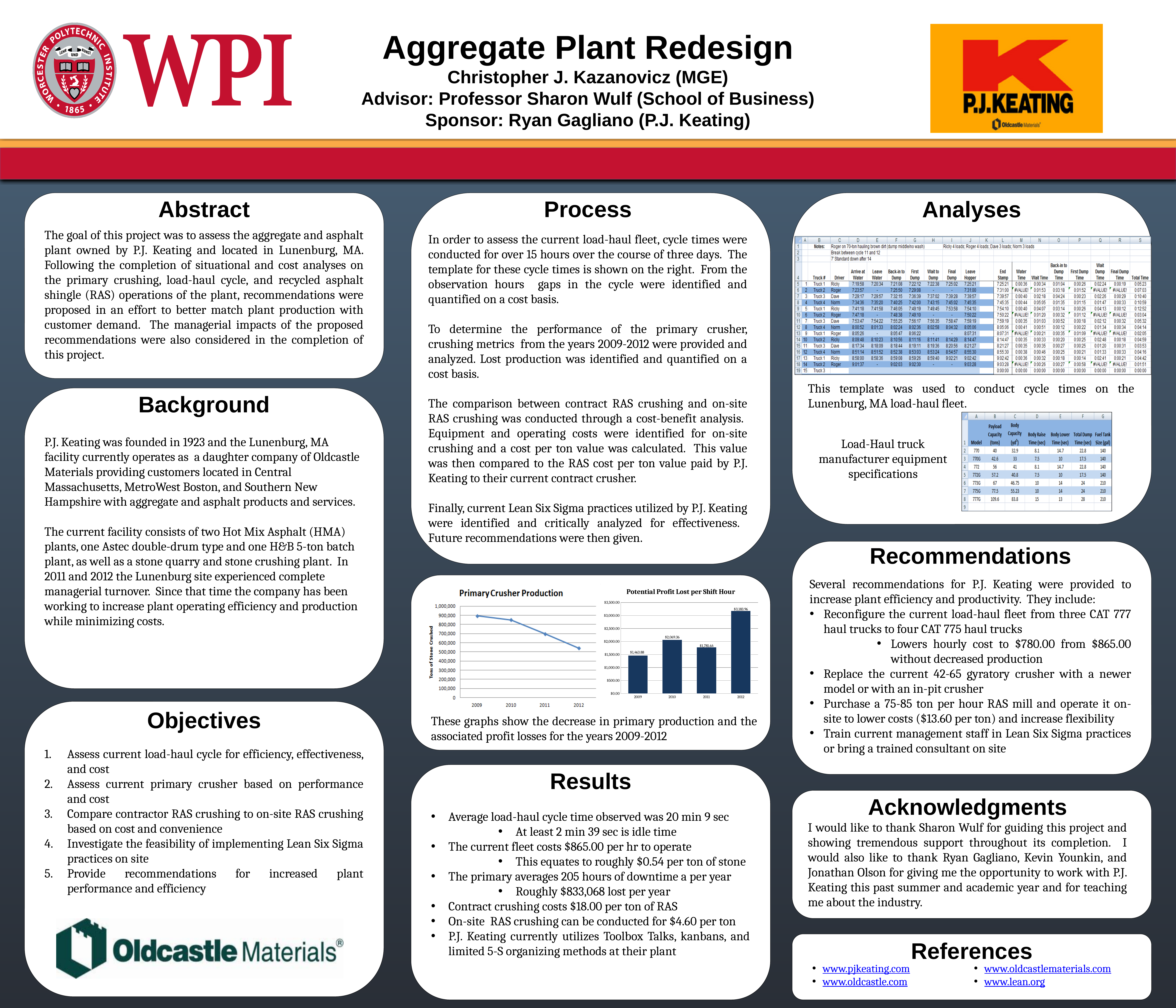
In the "Potential Profit Lost per Shift Hour" chart, what is the value for 2009? $1,463.88 What type of chart is the "Potential Profit Lost per Shift Hour" chart? bar chart In the "Primary Crusher Production" chart, do the values rise or fall from 2009 to 2012? fall In the "Potential Profit Lost per Shift Hour" chart, which year has the lowest value? 2009 How many years are plotted in the "Primary Crusher Production" chart? 4 In the "Potential Profit Lost per Shift Hour" chart, what is the value for 2012? $3,183.96 What type of chart is the "Primary Crusher Production" chart? line chart In the "Potential Profit Lost per Shift Hour" chart, which year has the highest value? 2012 In the "Potential Profit Lost per Shift Hour" chart, which is larger, the value for 2010 or the value for 2011? 2010 In the "Potential Profit Lost per Shift Hour" chart, what is the difference between the 2012 and 2009 values? $1,720.08 In the "Primary Crusher Production" chart, is the value for 2009 greater or less than 800,000? greater In the "Potential Profit Lost per Shift Hour" chart, what is the value for 2010? $2,069.36